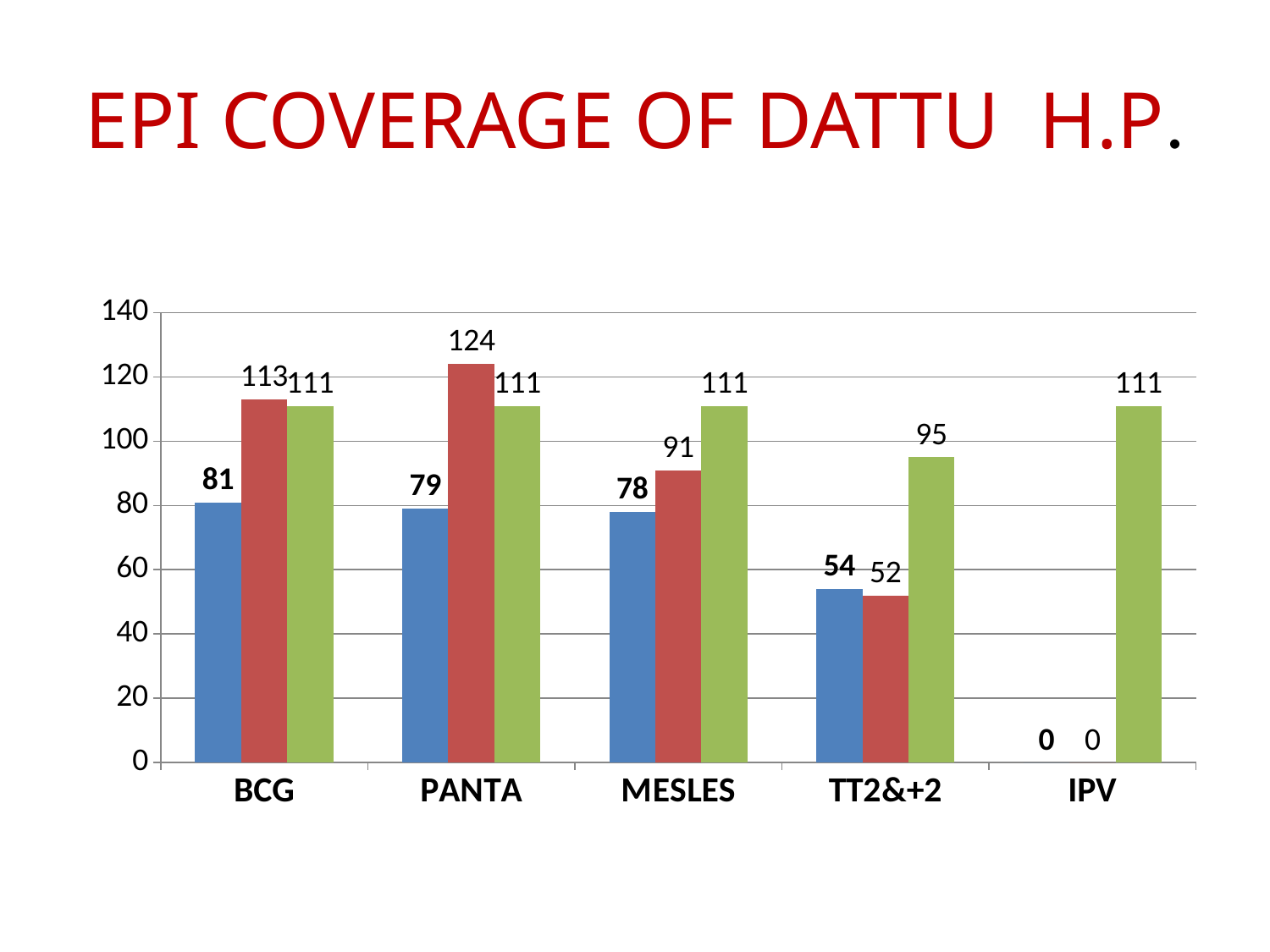
What is the value of the green bar for TT2&+2? 95 Which category has the lowest blue bar? IPV What is the difference between the red bar and the blue bar for BCG? 32 What kind of chart is shown on the slide? bar chart What is the title of the slide containing the chart? EPI COVERAGE OF DATTU H.P. Do the blue bar values rise or fall from BCG to IPV along the x axis? fall How many categories are shown on the x axis? 5 What is the value of the blue bar for BCG? 81 Which is larger for TT2&+2, the blue bar or the red bar? the blue bar What is the value of the red bar for MESLES? 91 Which category has the highest red bar? PANTA What is the value of the red bar for PANTA? 124